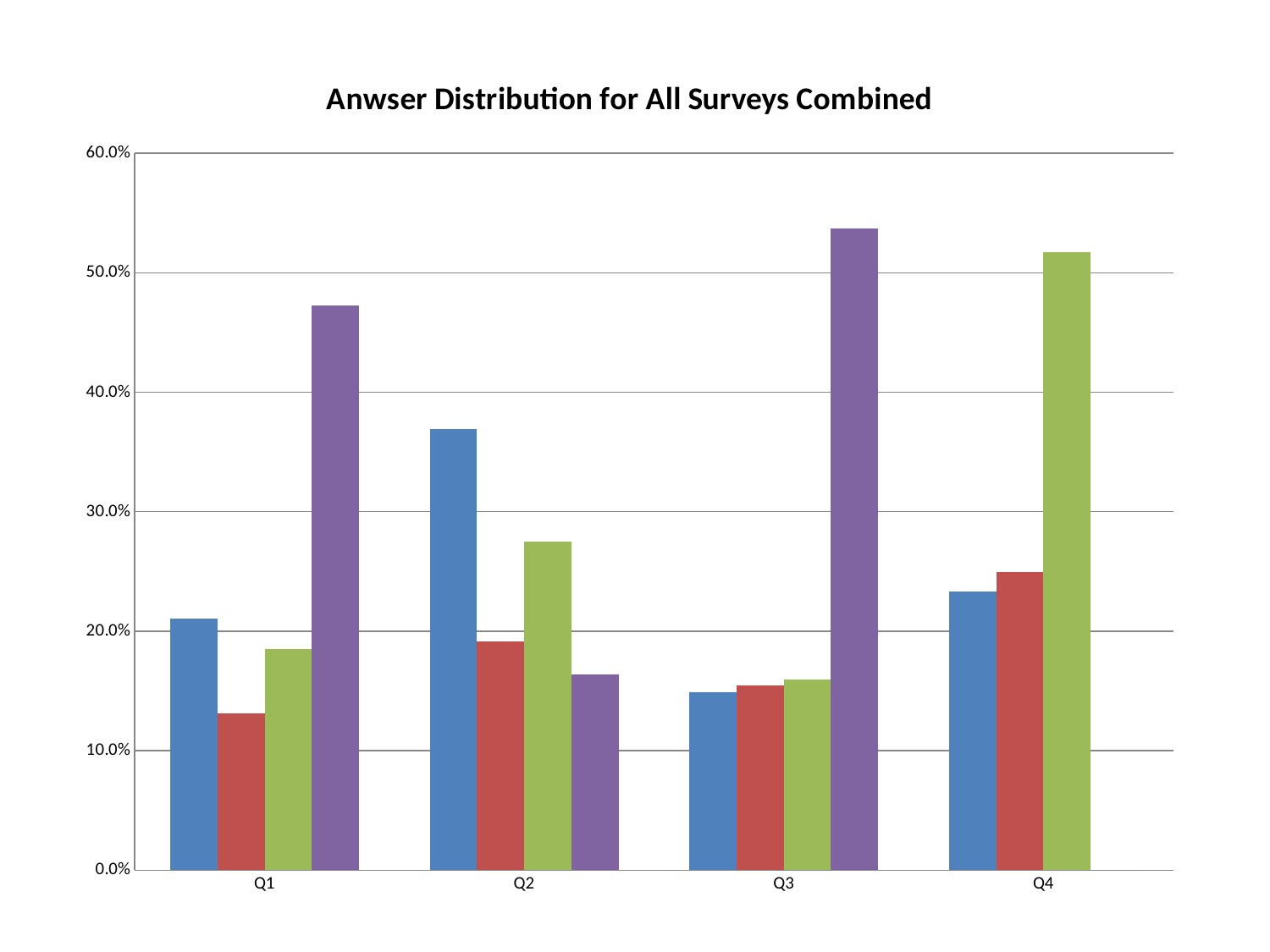
Is the value of the purple bar for Q3 greater or less than 50.0%? greater Is the value of the blue bar for Q2 greater or less than 30.0%? greater Is the value of the purple bar for Q1 greater or less than 40.0%? greater Which coloured bar is the lowest in Q1? red Which category has the tallest purple bar? Q3 Which category has the tallest blue bar? Q2 What kind of chart is shown on the slide? bar chart In Q2, which is larger, the blue bar or the green bar? blue What is the title of the chart? Anwser Distribution for All Surveys Combined How many categories are shown on the x axis? 4